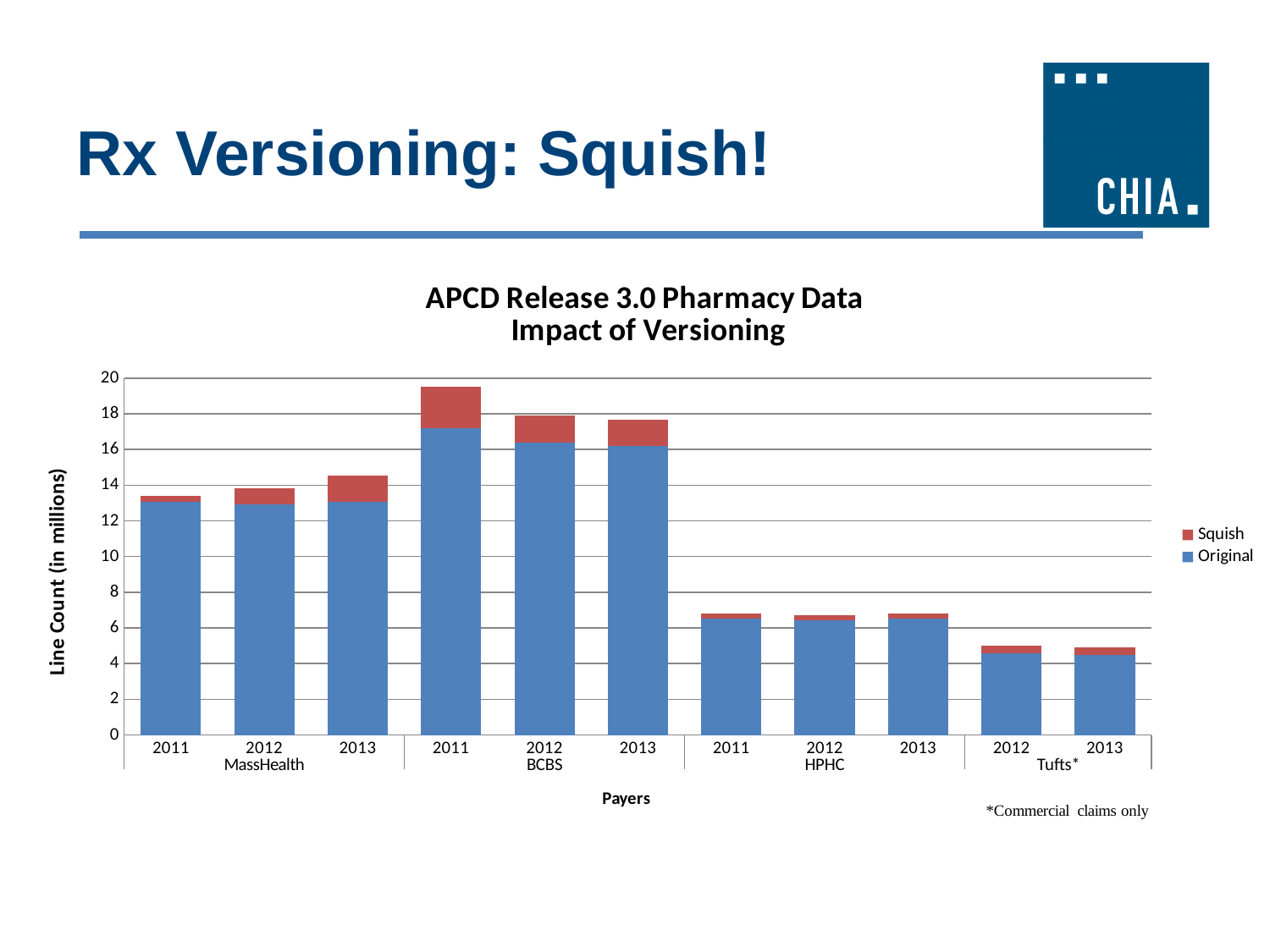
Which payer and year has the tallest bar? BCBS 2011 What is the label on the vertical axis? Line Count (in millions) What kind of chart is shown on the slide? Stacked bar chart Which is larger, the total bar for BCBS 2012 or for HPHC 2012? BCBS 2012 Is the total bar for MassHealth 2011 greater or less than 14? less Is the total bar for BCBS 2011 greater or less than 18? greater Do the MassHealth bars rise or fall from 2011 to 2013? rise How many bars are plotted in the chart? 11 Is the total bar for HPHC 2011 greater or less than 8? less Which payer has the lowest bars overall? Tufts* How many series does the legend list? 2